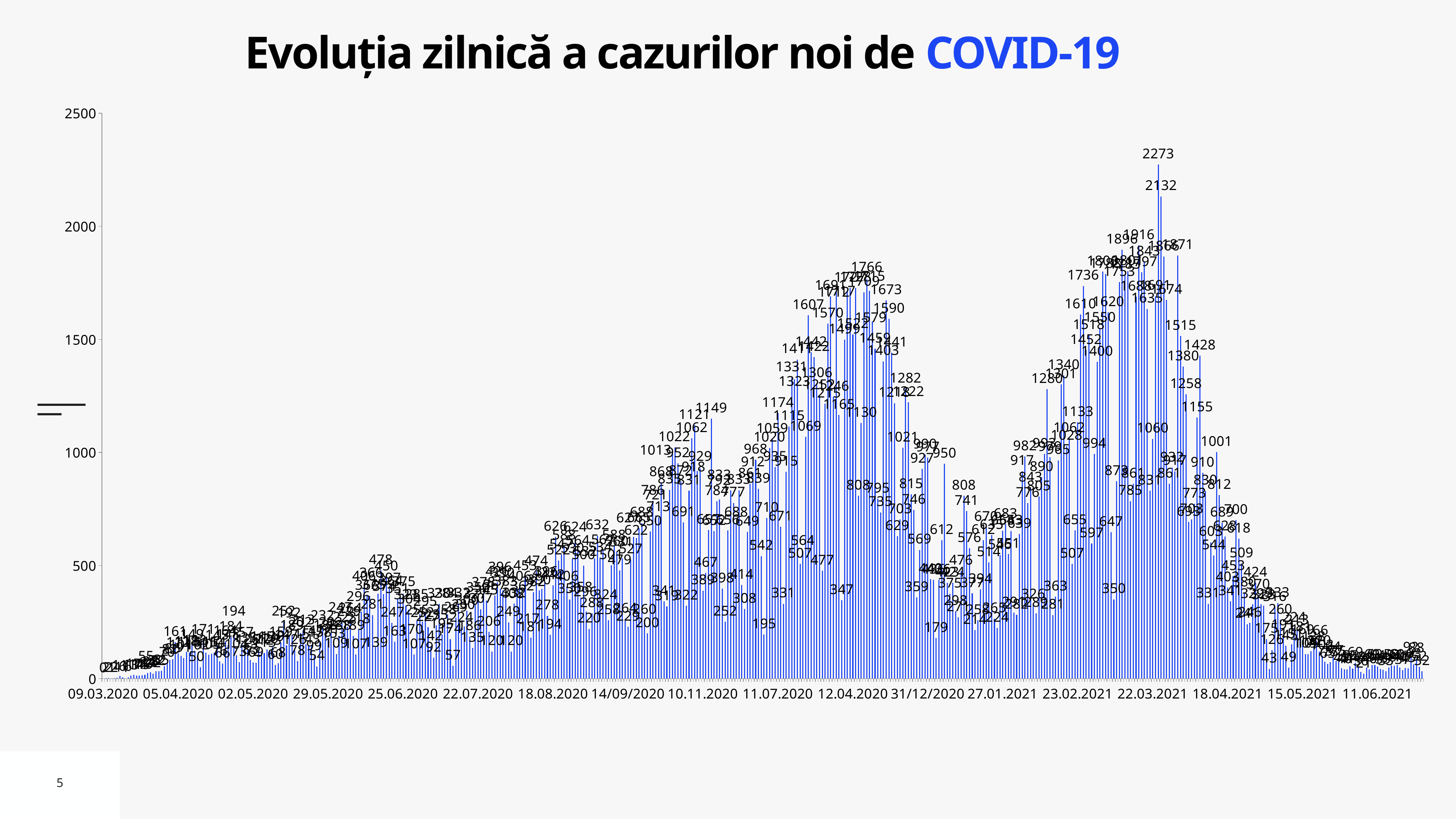
Is the peak value around 22.03.2021 greater or less than 1500? greater Is the highest value on the chart greater or less than 2000? greater What kind of chart is shown on the slide? bar chart What is the highest tick value shown on the vertical axis? 2500 What is the title of the chart? Evoluția zilnică a cazurilor noi de COVID-19 Do the values rise or fall between 15.05.2021 and 11.06.2021? fall What is the first date label on the horizontal axis? 09.03.2020 Which is larger, the peak labelled 2273 or the peak labelled 1766? 2273 Do the values rise or fall between 09.03.2020 and 05.04.2020? rise What is the highest daily value labelled on the chart? 2273 What is the last date label on the horizontal axis? 11.06.2021 What is the difference between the two highest labelled values, 2273 and 2132? 141